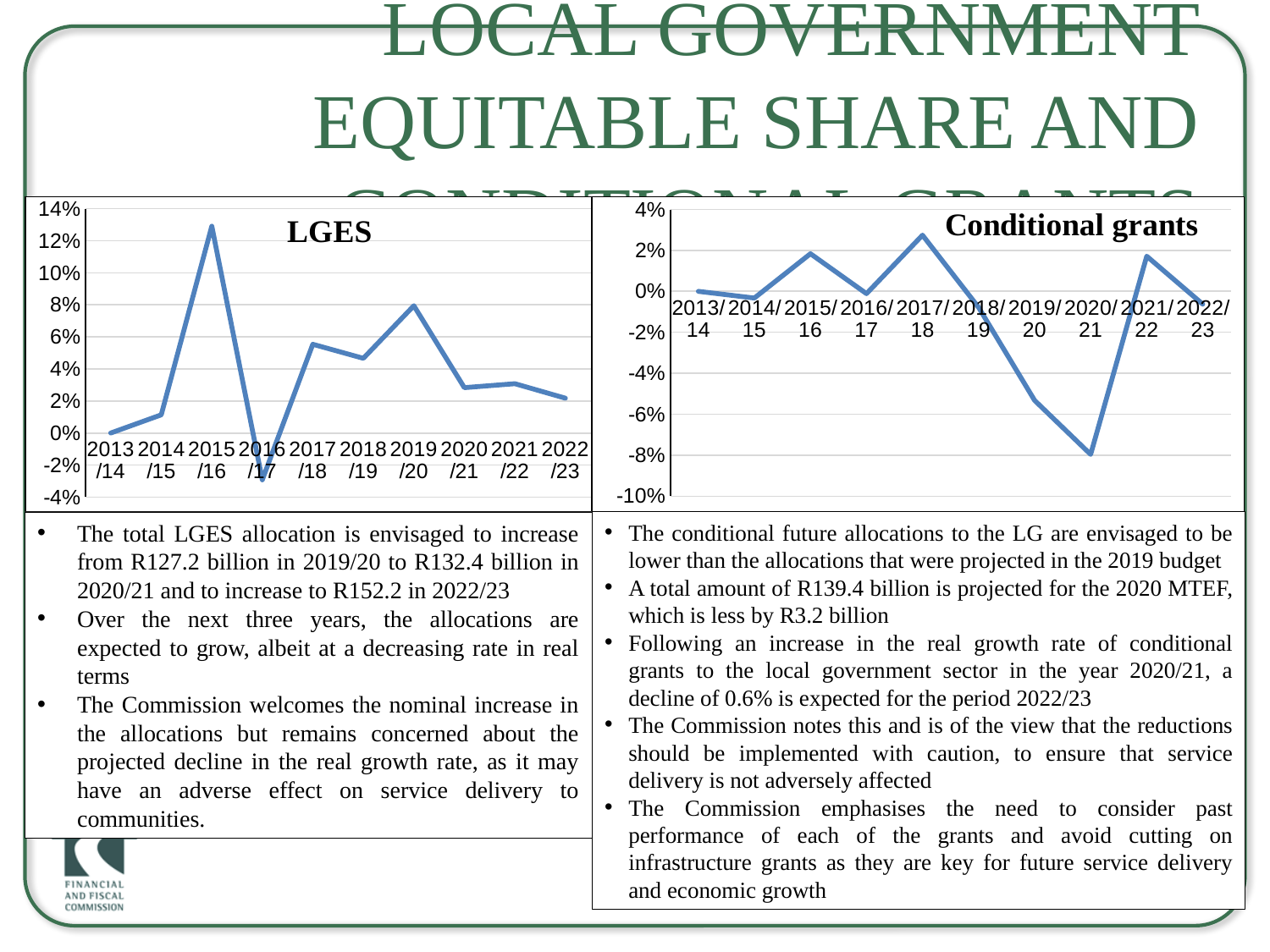
On the Conditional grants chart, is the value for 2020/21 greater or less than -4%? less On the LGES chart, which is larger, the value for 2015/16 or the value for 2019/20? 2015/16 On the Conditional grants chart, which year has the highest value? 2017/18 How many years are plotted on the Conditional grants chart? 10 On the LGES chart, is the value for 2015/16 greater or less than 10%? greater On the LGES chart, which year has the lowest value? 2016/17 On the LGES chart, is the value for 2016/17 greater or less than 0%? less On the LGES chart, do the values rise or fall from 2019/20 to 2022/23? fall What kind of chart is the LGES chart? line chart On the LGES chart, which year has the highest value? 2015/16 On the Conditional grants chart, which year has the lowest value? 2020/21